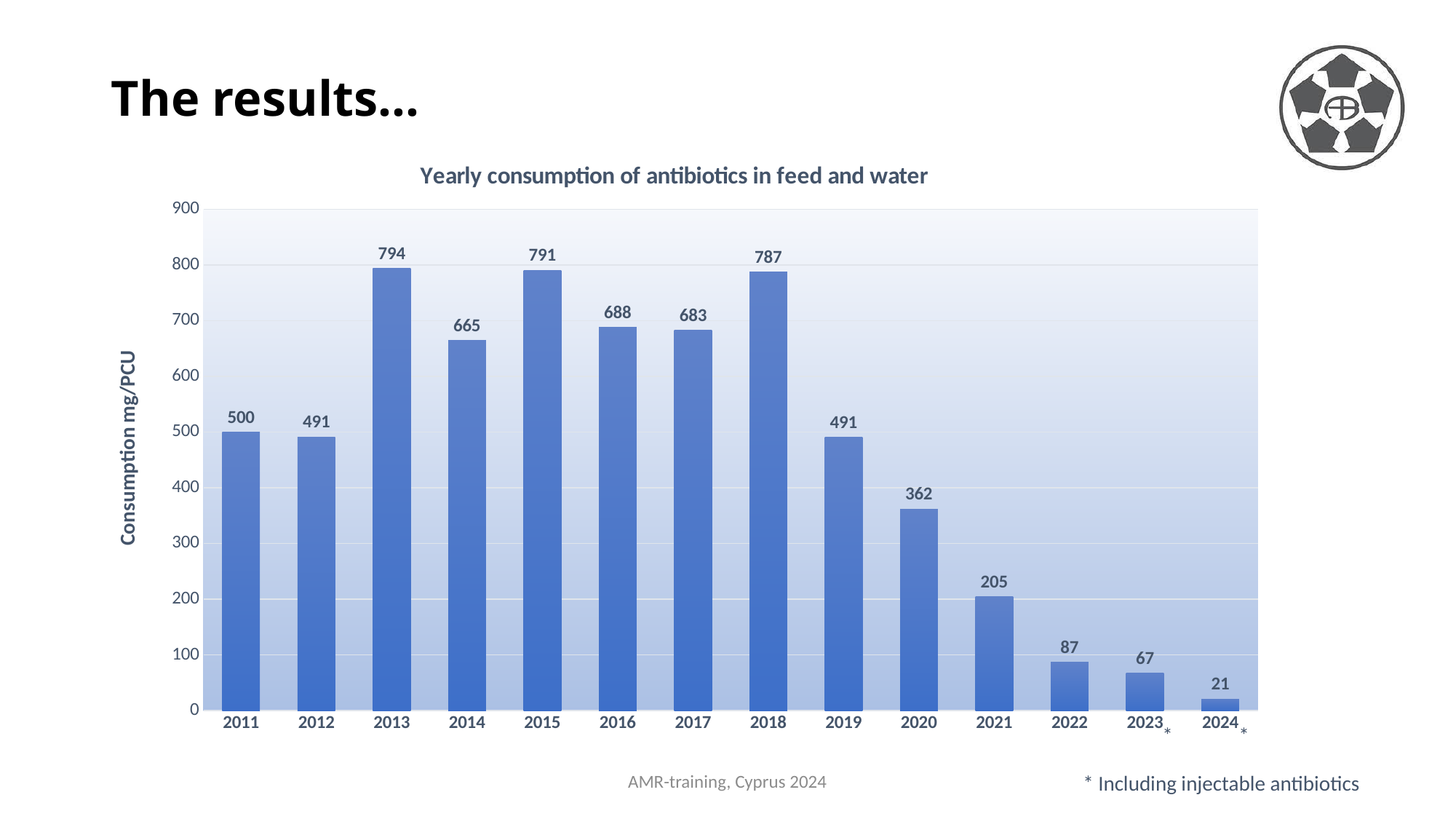
What kind of chart is shown on the slide? Bar chart Do the values rise or fall from 2018 to 2024? Fall What is the title of the chart? Yearly consumption of antibiotics in feed and water What is the consumption value for 2024? 21 What is the difference between the consumption in 2018 and in 2019? 296 What is the consumption value for 2020? 362 Which year has the larger consumption, 2014 or 2016? 2016 Which year has the lowest consumption? 2024 Is the value for 2021 greater or less than 300? less How many years are shown on the x axis? 14 What is the consumption value for 2013? 794 Which year has the highest consumption? 2013